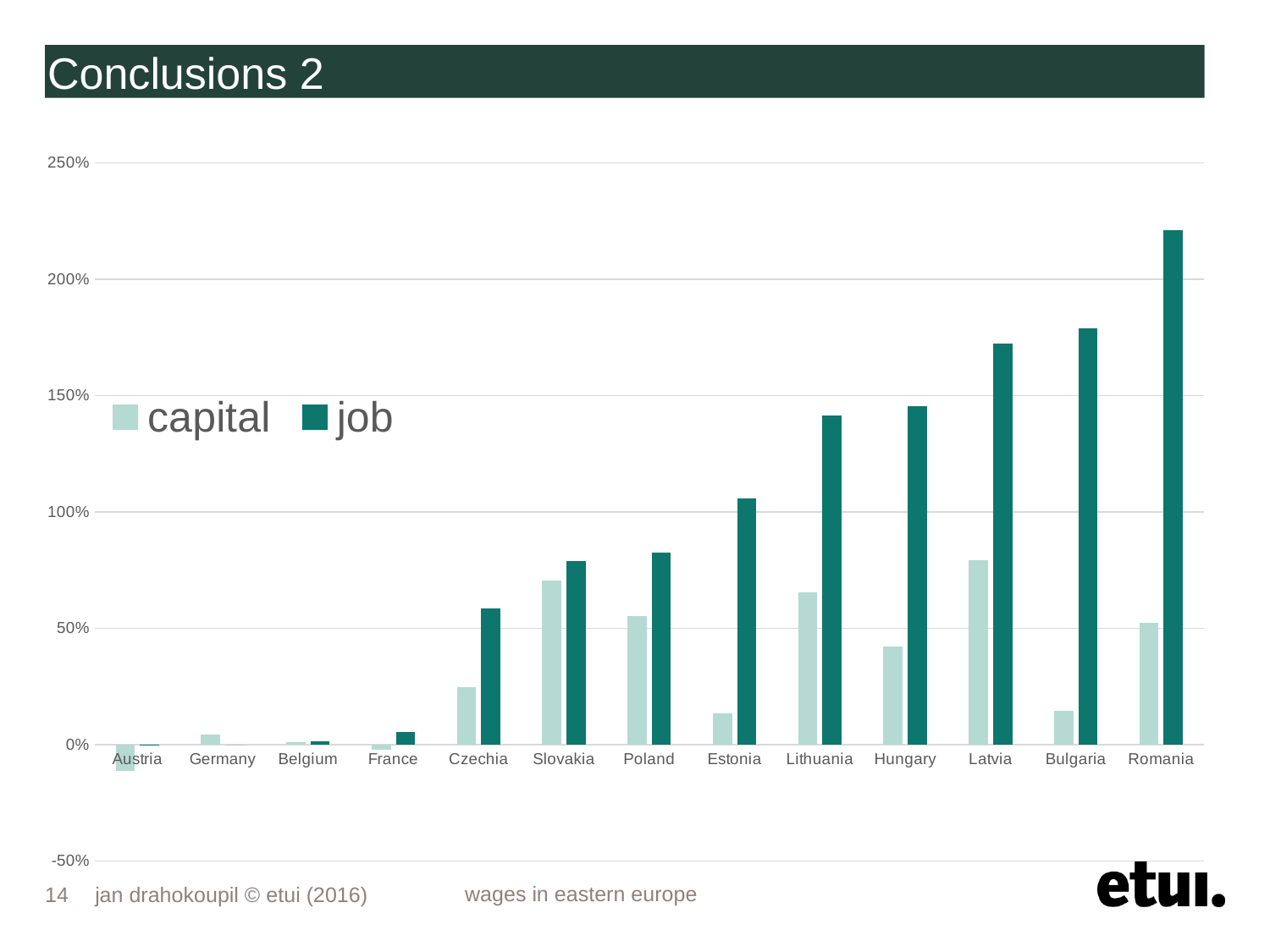
Do the job values generally rise or fall moving from Austria on the left to Romania on the right? rise Is the capital value for Czechia greater or less than 50%? less Which country has the highest value for the job series? Romania Which country has the lowest value for the capital series? Austria Is the job value for Romania greater or less than 200%? greater Which is larger, the job value for Romania or the job value for Latvia? Romania Is the capital value for Slovakia greater or less than 50%? greater What kind of chart is shown on the slide? bar chart How many series does the chart's legend list? 2 How many countries are shown on the x axis of the chart? 13 What are the two series named in the legend? capital and job